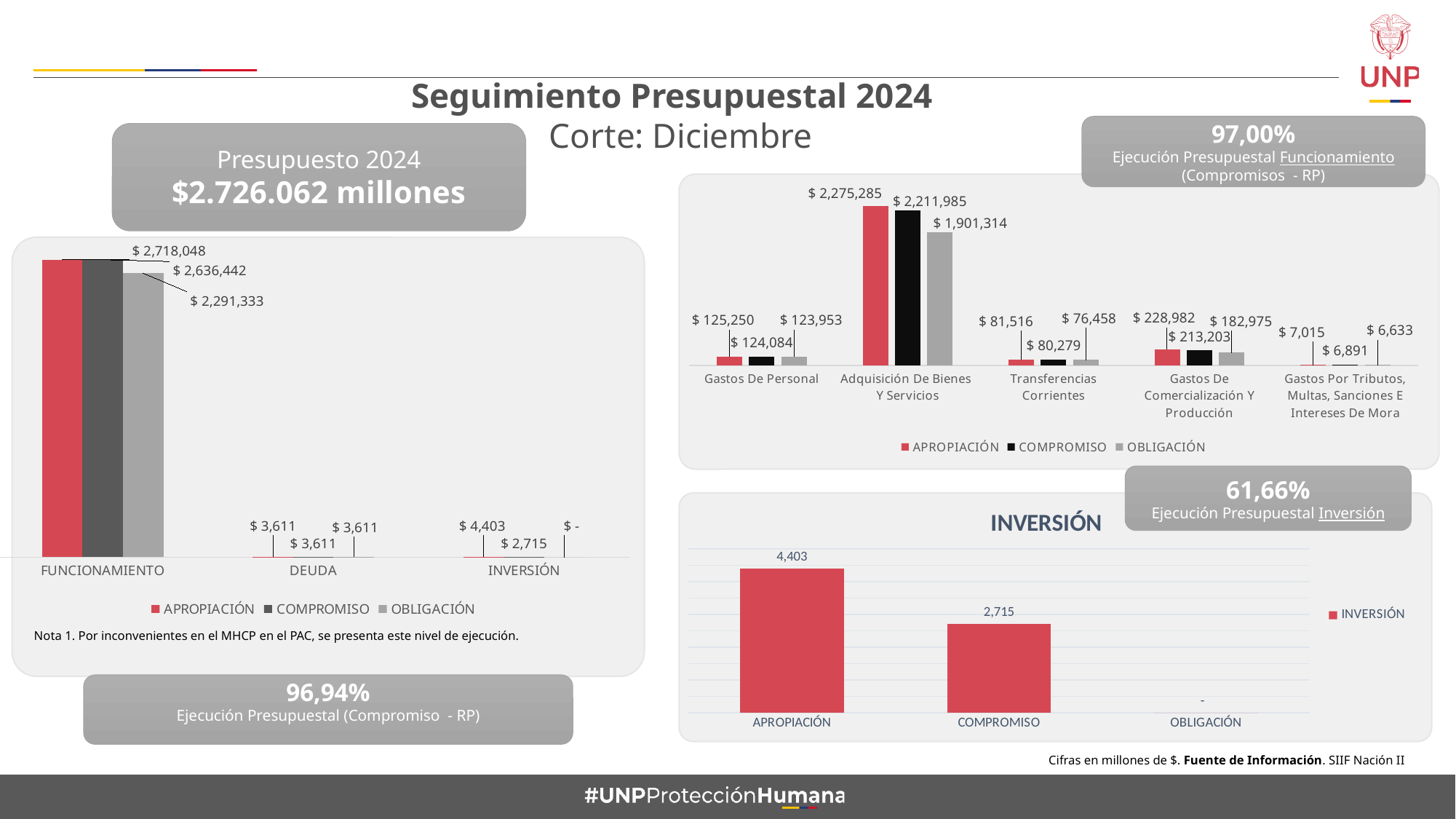
How many series does the legend of the top-right chart list? 3 In the left chart, what is the OBLIGACIÓN value for DEUDA? $ 3,611 In the bottom-right INVERSIÓN chart, what is the difference between APROPIACIÓN and COMPROMISO? 1,688 In the top-right chart, which has the larger APROPIACIÓN value: Gastos De Personal or Gastos De Comercialización Y Producción? Gastos De Comercialización Y Producción In the bottom-right INVERSIÓN chart, what is the value for COMPROMISO? 2,715 In the left chart, what is the APROPIACIÓN value for FUNCIONAMIENTO? $ 2,718,048 In the top-right chart, which category has the lowest COMPROMISO value? Gastos Por Tributos, Multas, Sanciones E Intereses De Mora How many categories are shown on the x axis of the bottom-right INVERSIÓN chart? 3 In the left chart, what is the difference between the APROPIACIÓN and COMPROMISO values for FUNCIONAMIENTO? $ 81,606 In the top-right chart, which category has the highest APROPIACIÓN value? Adquisición De Bienes Y Servicios What kind of chart is the bottom-right INVERSIÓN chart? Bar chart In the top-right chart, what is the OBLIGACIÓN value for Adquisición De Bienes Y Servicios? $ 1,901,314